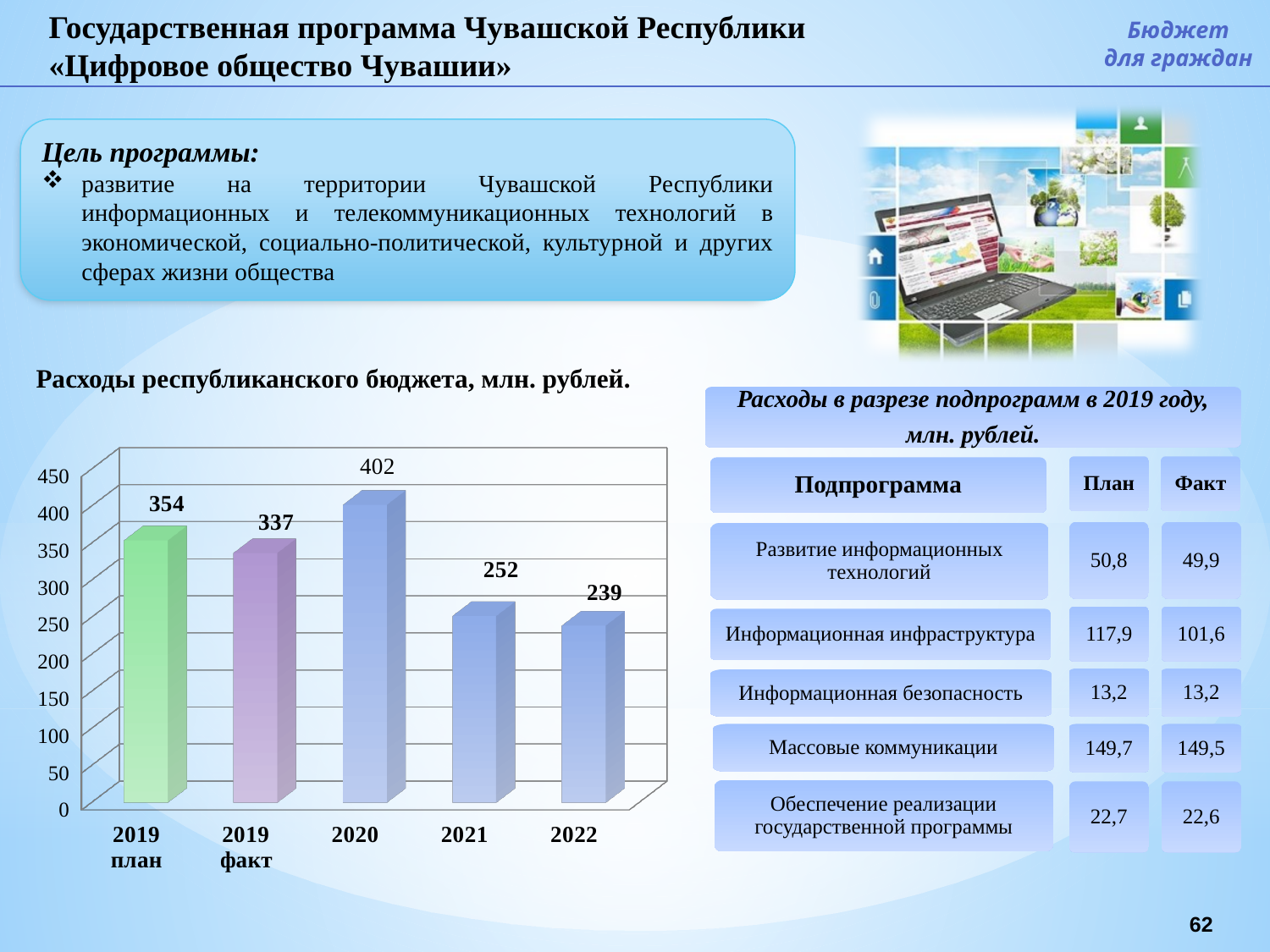
What is the difference between the values for 2019 план and 2019 факт? 17 Which category has the highest value in the chart? 2020 What is the value for 2022 in the chart? 239 How many categories are shown on the x axis of the chart? 5 What is the value for 2019 план in the chart? 354 Which is larger, the value for 2021 or the value for 2022? 2021 Which category has the lowest value in the chart? 2022 Is the value for 2020 greater or less than 400? greater Do the values rise or fall from 2020 to 2022 in the chart? fall What is the difference between the values for 2020 and 2021? 150 What is the value for 2020 in the chart "Расходы республиканского бюджета, млн. рублей"? 402 What kind of chart is shown on the slide? bar chart